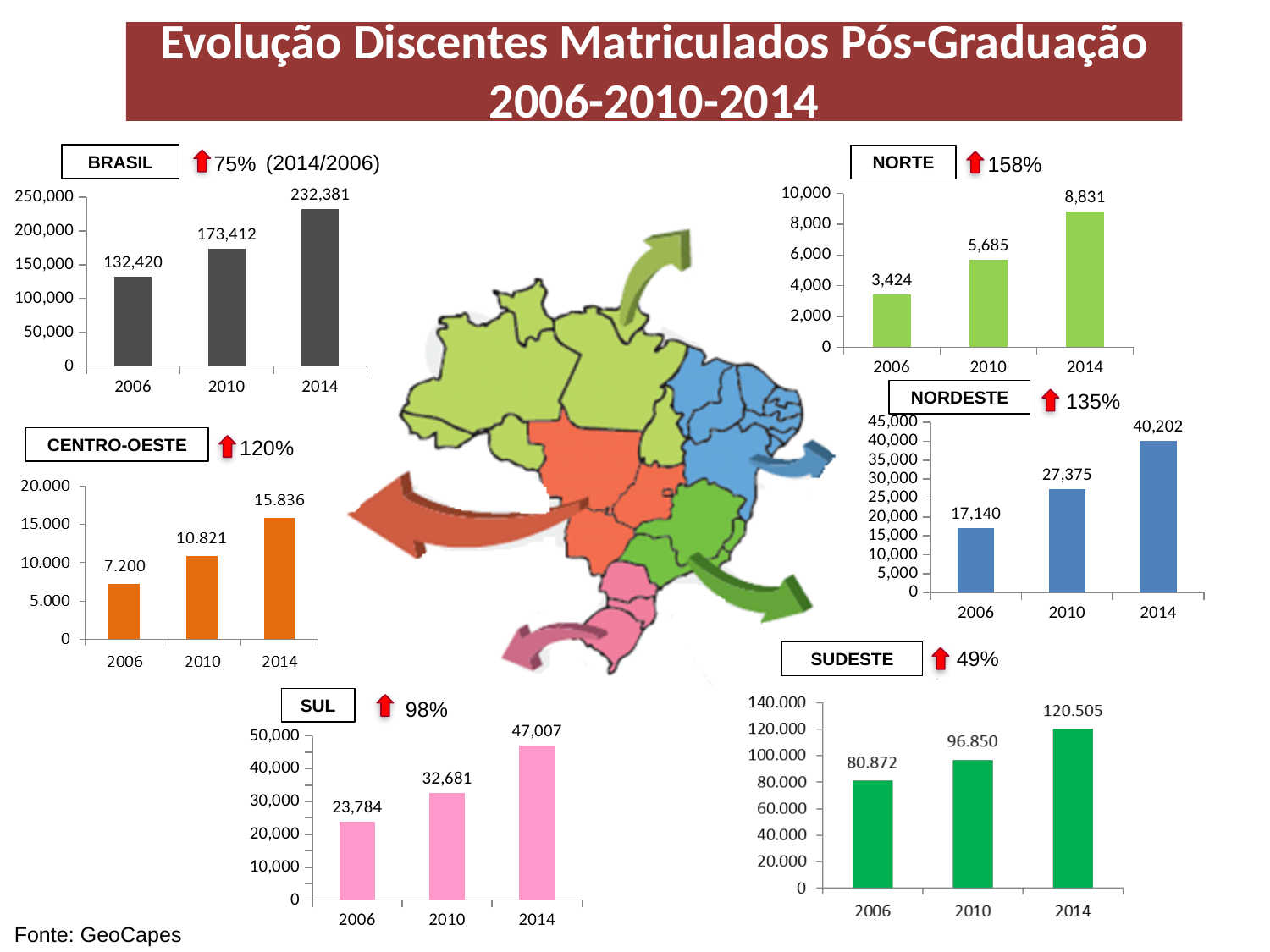
In the CENTRO-OESTE chart, what is the value for 2010? 10.821 How many years are shown on the x axis of the SUDESTE chart? 3 In the NORTE chart, what is the difference between the 2014 and 2010 values? 3,146 In the BRASIL chart, what is the difference between the 2014 and 2006 values? 99,961 In the CENTRO-OESTE chart, do the values rise or fall from 2006 to 2014? Rise In the BRASIL chart, what is the value for 2014? 232,381 In the SUL chart, which is larger, the value for 2010 or the value for 2014? 2014 In the SUL chart, which year has the lowest value? 2006 What kind of chart is the NORDESTE chart? Bar chart In the NORTE chart, what is the value for 2006? 3,424 In the SUDESTE chart, what is the value for 2014? 120.505 In the NORDESTE chart, which year has the highest value? 2014